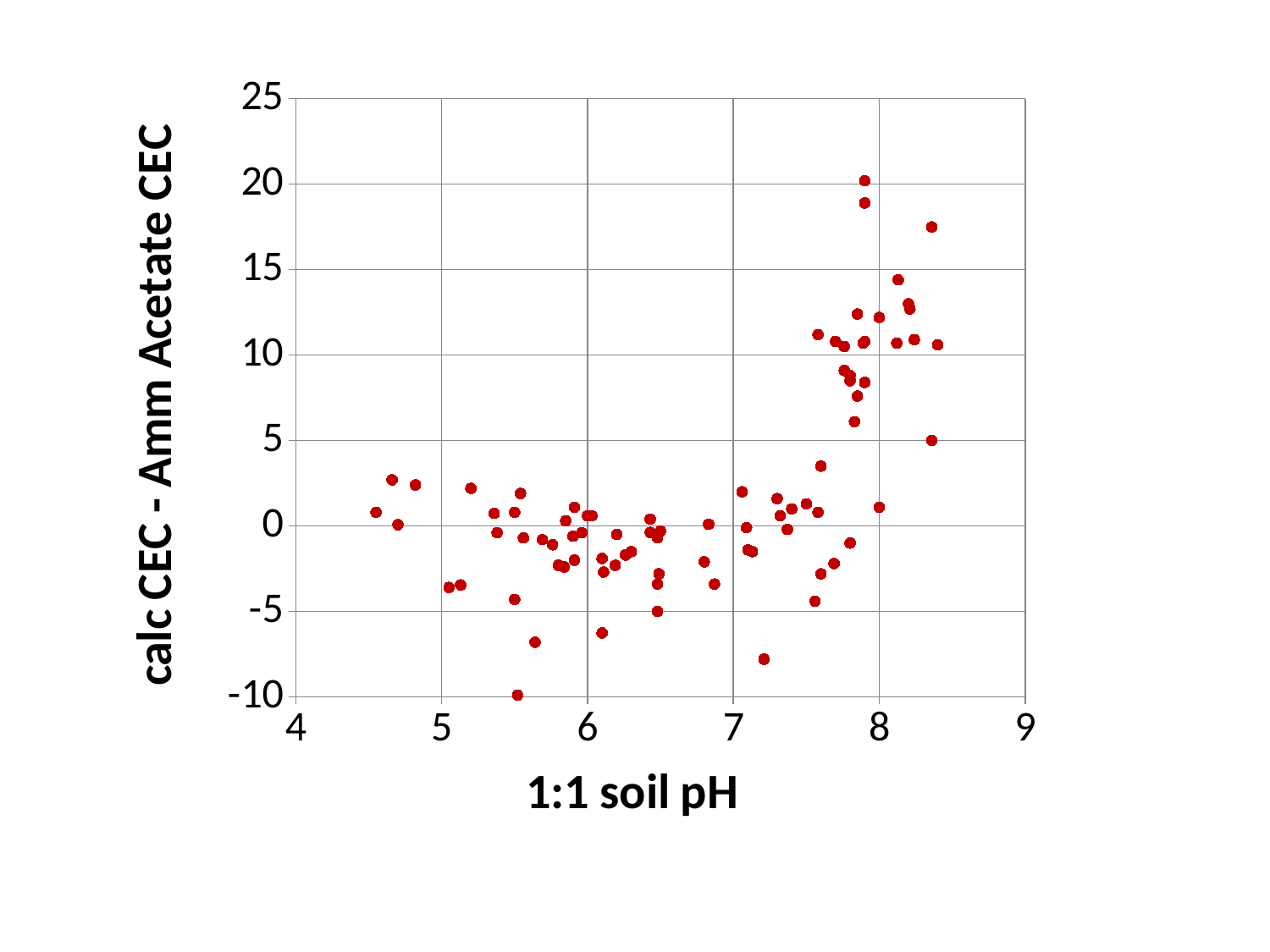
As soil pH increases from about 7.5 to 8, do the plotted values generally rise or fall? rise For soil pH values between 5 and 7, are the plotted values greater or less than 5? less What is the label of the x axis? 1:1 soil pH Is the lowest plotted value on the chart greater or less than -5? less What is the maximum value shown on the y axis? 25 What is the label of the y axis? calc CEC - Amm Acetate CEC Which region of the x axis contains the points with the largest y values: pH below 7 or pH above 7.5? pH above 7.5 Is the point with the lowest y value located at a soil pH greater or less than 6? less What kind of chart is shown on the slide? scatter chart